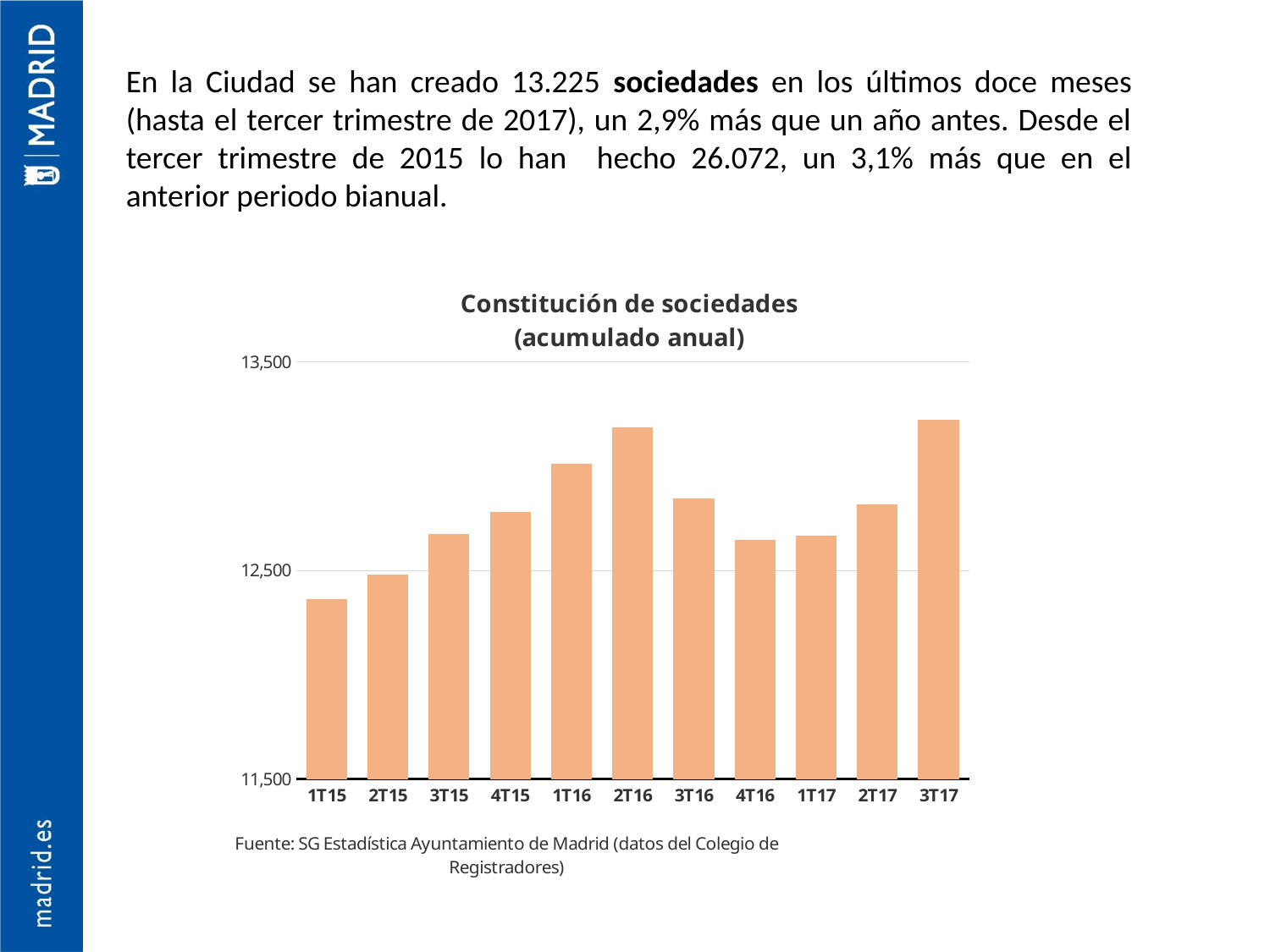
How many quarters (bars) are plotted in the chart? 11 Is the value for 3T15 greater or less than 12,500? greater Which quarter has the highest value in the chart? 3T17 What is the title of the chart? Constitución de sociedades (acumulado anual) Which is larger, the value for 4T15 or the value for 1T16? 1T16 Do the values rise or fall from 1T15 to 2T16? rise Which is larger, the value for 2T16 or the value for 3T16? 2T16 Is the value for 3T17 greater or less than 12,500? greater Is the value for 2T16 greater or less than 13,500? less Which quarter has the lowest value in the chart? 1T15 What kind of chart is shown on the slide? Bar chart